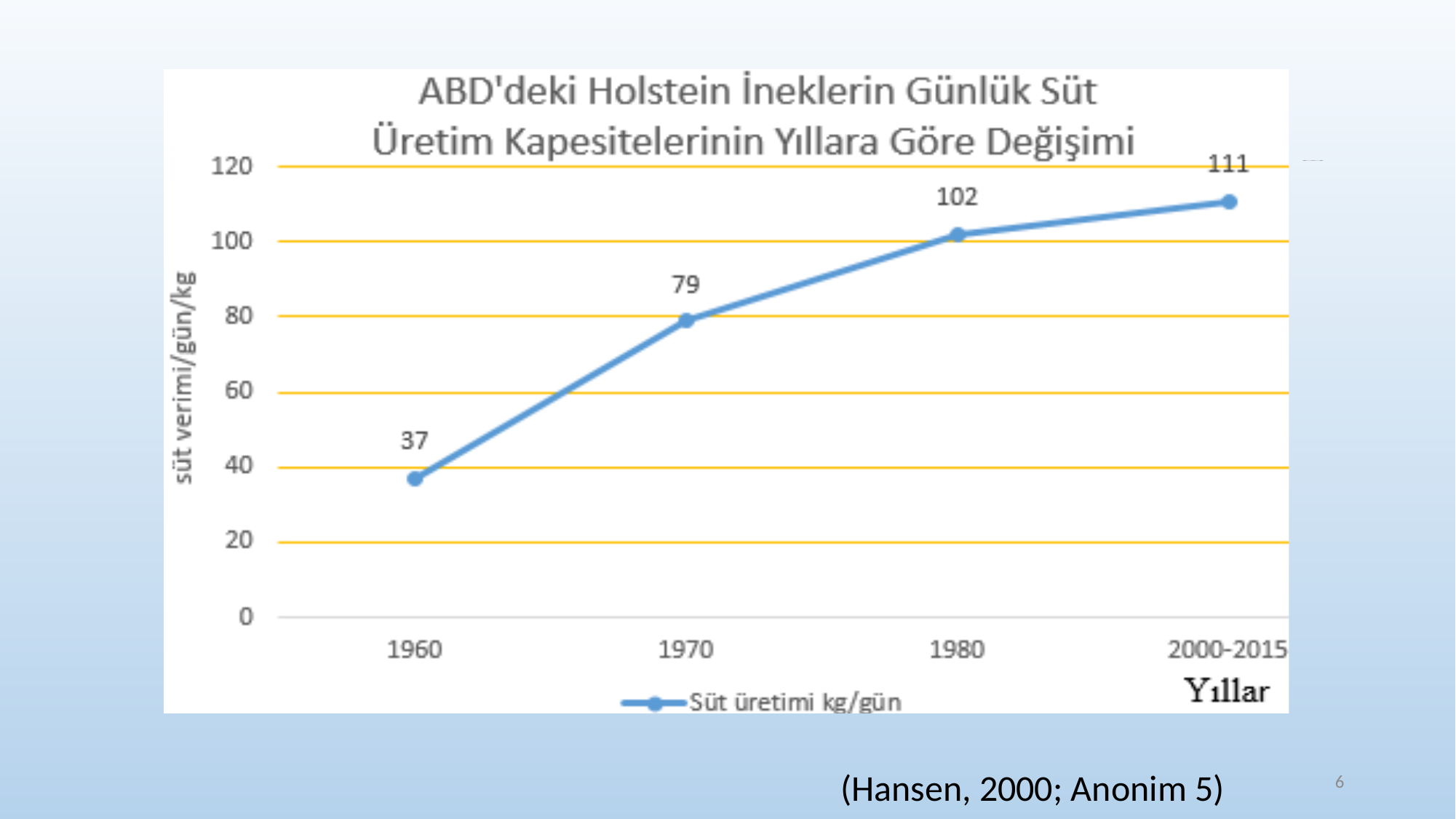
Which period has the highest milk production value? 2000-2015 What is the difference between the milk production values for 2000-2015 and 1970? 32 Which year has the lowest milk production value? 1960 What is the milk production value for 1960? 37 What kind of chart is shown on the slide? Line chart What is the difference between the milk production values for 1980 and 1960? 65 Which has a larger milk production value, 1970 or 1980? 1980 Do the values rise or fall from 1960 to 2000-2015? Rise What is the milk production value for 1980? 102 What is the milk production value for 2000-2015? 111 What is the milk production value for 1970? 79 How many data points are plotted on the chart? 4